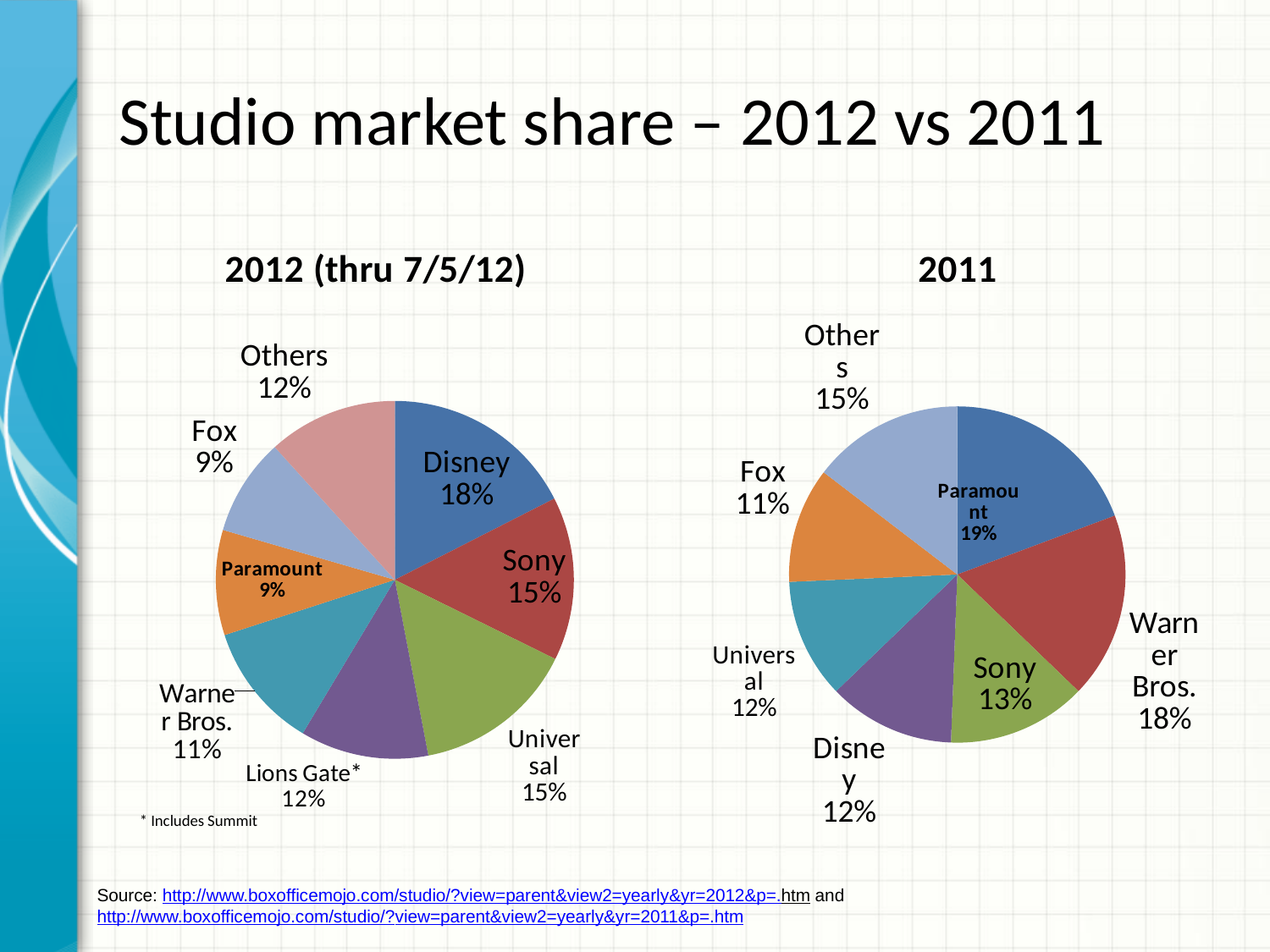
In the 2011 pie chart, what share does Paramount have? 19% In the 2012 (thru 7/5/12) pie chart, what is the difference between Disney's share and Paramount's share? 9% In the 2012 (thru 7/5/12) pie chart, what share does Lions Gate* have? 12% In the 2011 pie chart, which studio has the largest share? Paramount How many slices does the 2011 pie chart have? 7 In the 2012 (thru 7/5/12) pie chart, which studio has the largest share? Disney In the 2012 (thru 7/5/12) pie chart, what share does Disney have? 18% How many slices does the 2012 (thru 7/5/12) pie chart have? 8 In the 2011 pie chart, which is larger, Sony's share or Disney's share? Sony In the 2011 pie chart, which studio has the smallest share? Fox What type of chart is used to show the 2011 studio market share? Pie chart In the 2011 pie chart, what share does Warner Bros. have? 18%